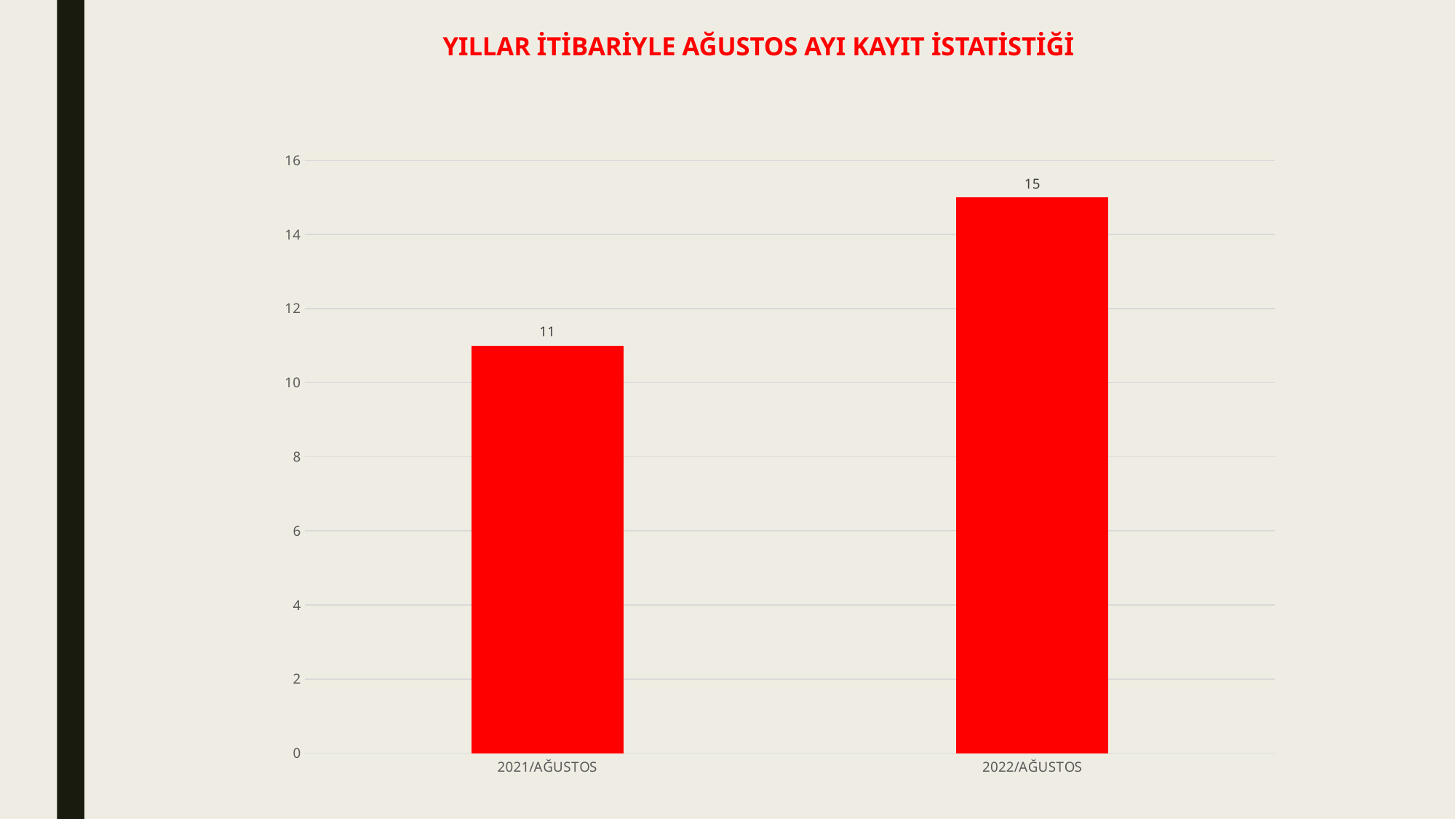
Is the value for 2021/AĞUSTOS greater or less than 12? less What is the title of the chart? YILLAR İTİBARİYLE AĞUSTOS AYI KAYIT İSTATİSTİĞİ What kind of chart is shown on the slide? bar chart Which is larger, the value for 2021/AĞUSTOS or the value for 2022/AĞUSTOS? 2022/AĞUSTOS What is the difference between the values for 2022/AĞUSTOS and 2021/AĞUSTOS? 4 Do the values rise or fall from 2021/AĞUSTOS to 2022/AĞUSTOS? rise Which category has the lowest value? 2021/AĞUSTOS What is the value for 2022/AĞUSTOS? 15 How many categories are shown on the x axis? 2 Which category has the highest value? 2022/AĞUSTOS What is the value for 2021/AĞUSTOS? 11 Is the value for 2022/AĞUSTOS greater or less than 14? greater